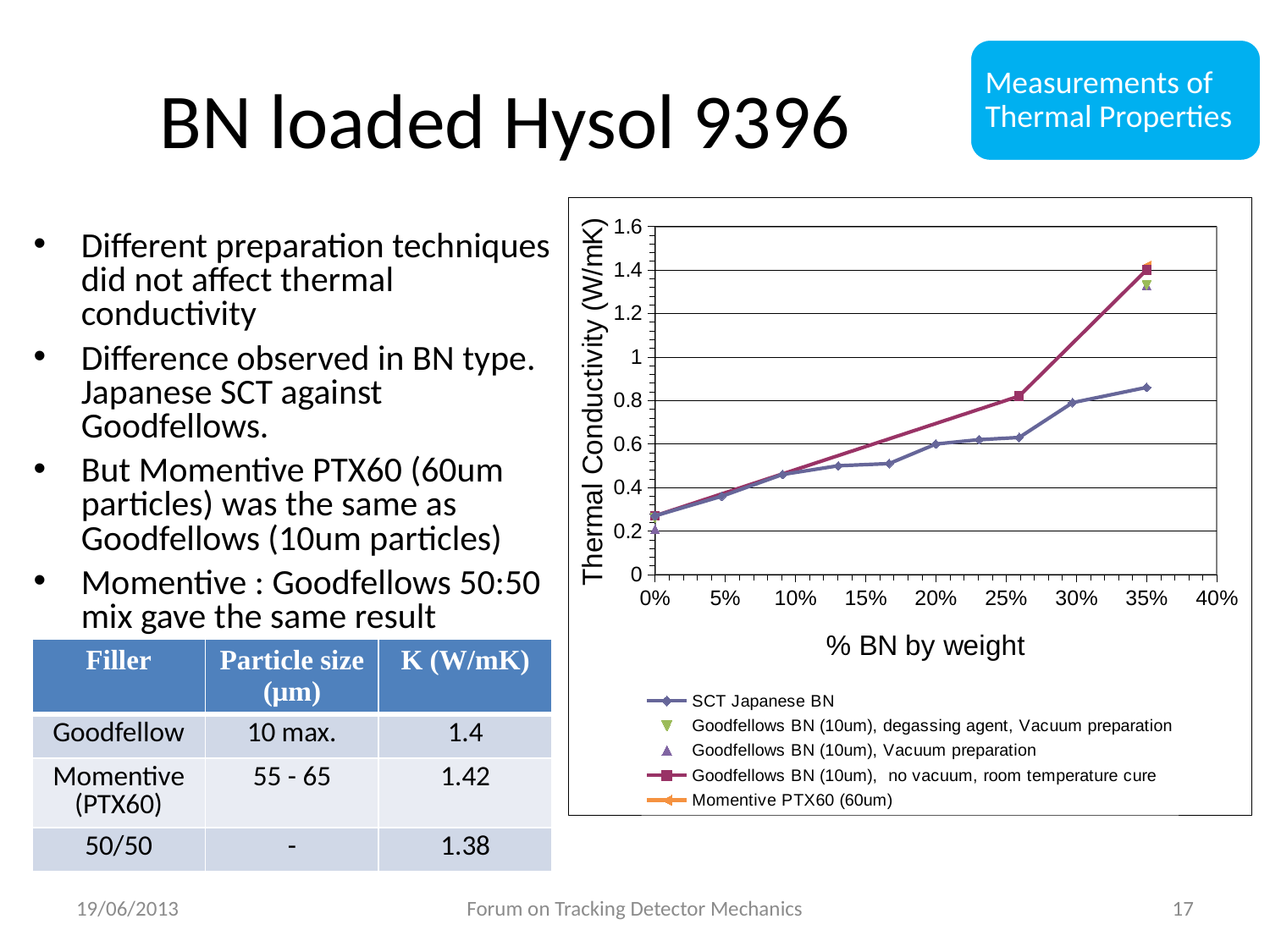
What kind of chart is shown on the slide? line chart Is the thermal conductivity of SCT Japanese BN at 35% BN by weight greater or less than 0.8? greater Is the thermal conductivity of Goodfellows BN (10um), no vacuum, room temperature cure at 25% BN by weight greater or less than 0.6? greater Which series has the highest thermal conductivity at 35% BN by weight: SCT Japanese BN or Momentive PTX60 (60um)? Momentive PTX60 (60um) At 35% BN by weight, which series has the higher thermal conductivity: SCT Japanese BN or Goodfellows BN (10um), no vacuum, room temperature cure? Goodfellows BN (10um), no vacuum, room temperature cure What is the label of the chart's x axis? % BN by weight How many series does the chart legend list? 5 Is the thermal conductivity of SCT Japanese BN at 35% BN by weight greater or less than 1? less What is the label of the chart's y axis? Thermal Conductivity (W/mK) Does the thermal conductivity of SCT Japanese BN rise or fall as % BN by weight increases? rise